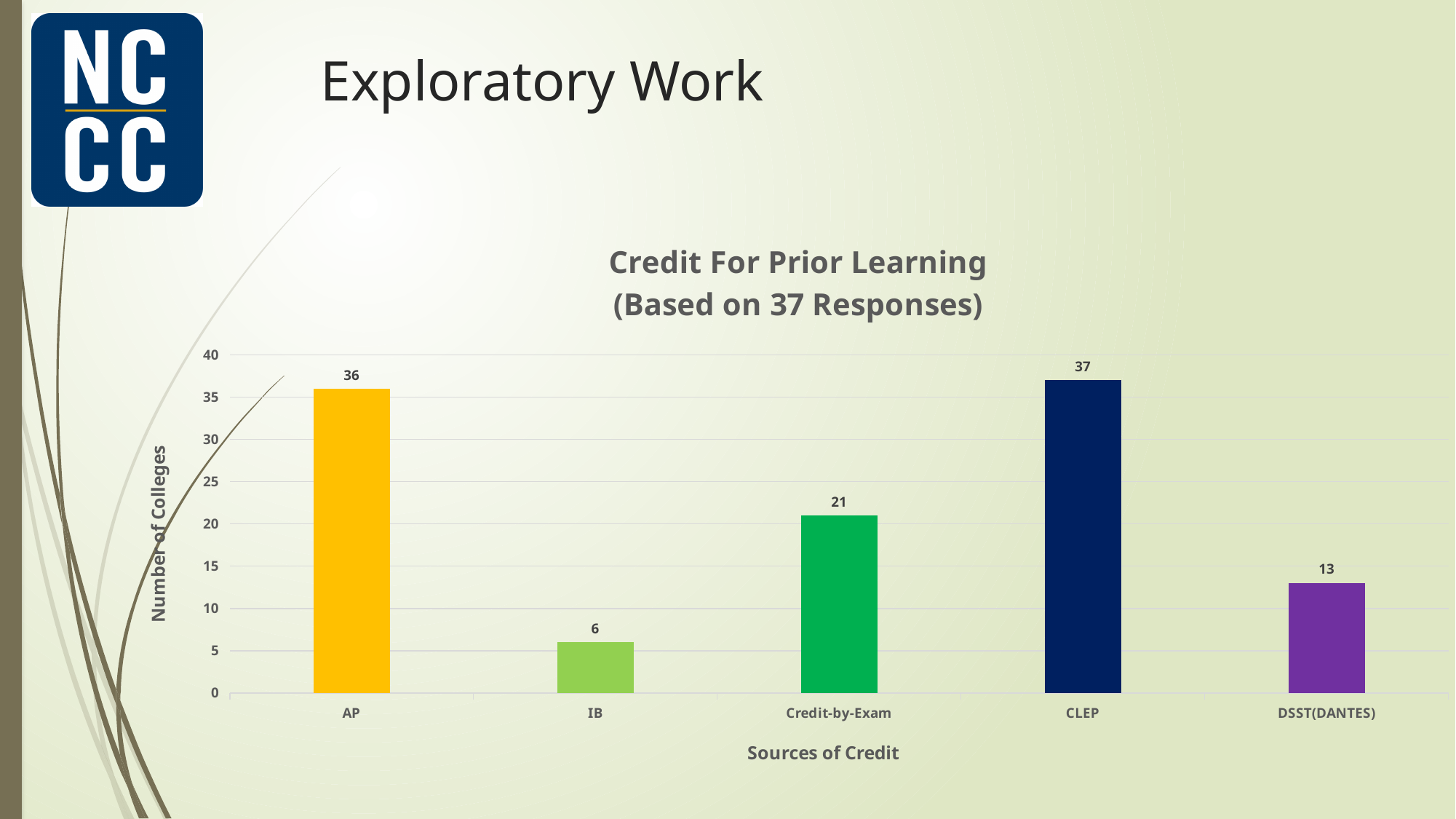
What is the value for AP? 36 Is the value for DSST(DANTES) greater or less than 15? less What is the value for IB? 6 How many sources of credit are shown on the x axis? 5 What is the value for Credit-by-Exam? 21 What is the difference between the values for CLEP and Credit-by-Exam? 16 Which source of credit has the highest number of colleges? CLEP Which is larger, the value for Credit-by-Exam or the value for DSST(DANTES)? Credit-by-Exam Which source of credit has the lowest number of colleges? IB What is the value for DSST(DANTES)? 13 What kind of chart is shown on the slide? bar chart What is the title of the chart? Credit For Prior Learning (Based on 37 Responses)